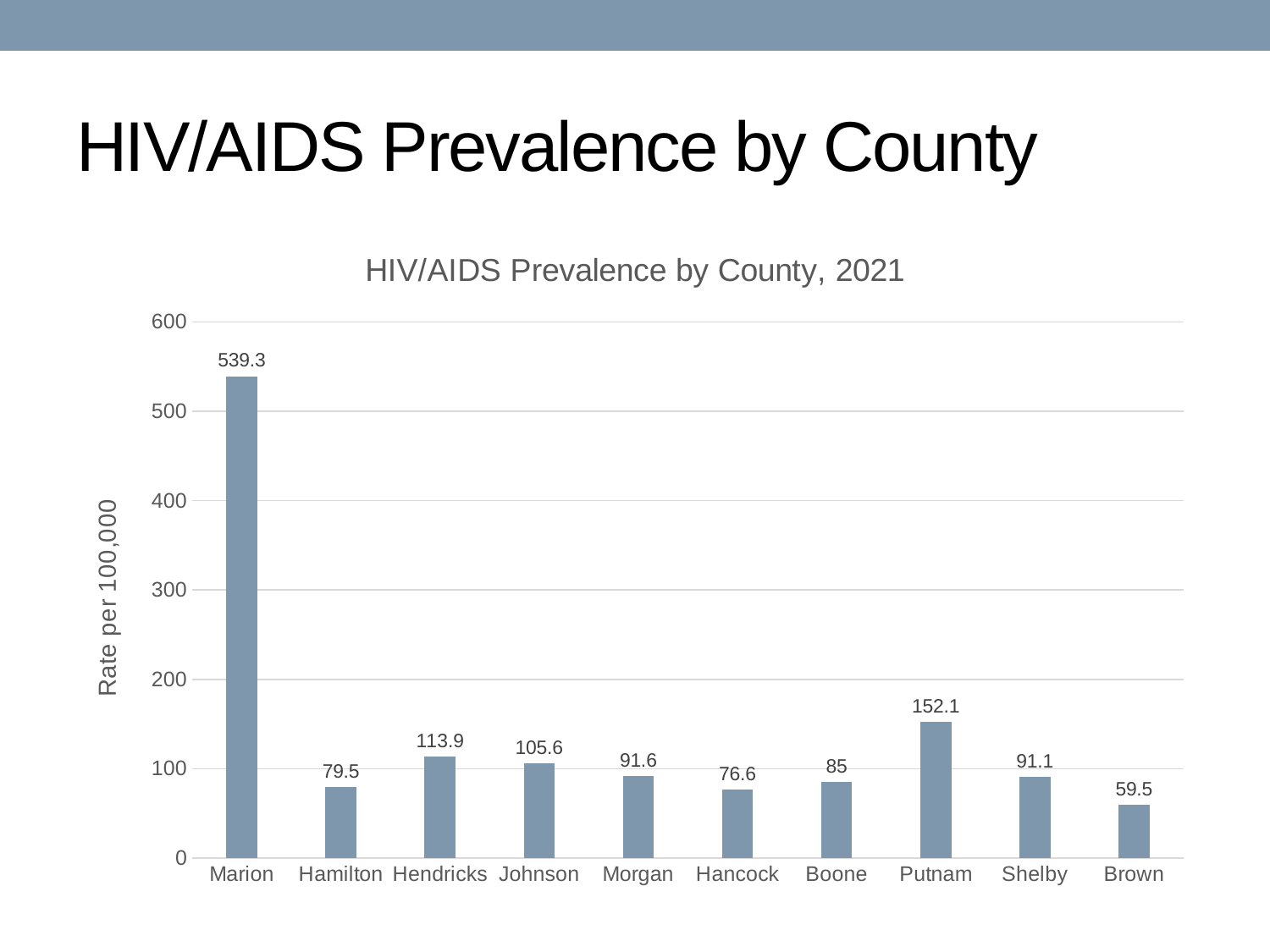
What is the HIV/AIDS prevalence rate for Boone County? 85 Is the value for Shelby greater or less than 100? less What is the difference between the rates for Hendricks and Johnson counties? 8.3 What kind of chart is shown on the slide? bar chart What is the HIV/AIDS prevalence rate for Putnam County? 152.1 Which county has a higher rate, Hamilton or Hancock? Hamilton Which county has the highest HIV/AIDS prevalence rate? Marion What is the label on the vertical axis of the chart? Rate per 100,000 How many counties are shown in the chart? 10 Which county has the lowest HIV/AIDS prevalence rate? Brown What is the HIV/AIDS prevalence rate for Marion County? 539.3 What is the title of the chart? HIV/AIDS Prevalence by County, 2021